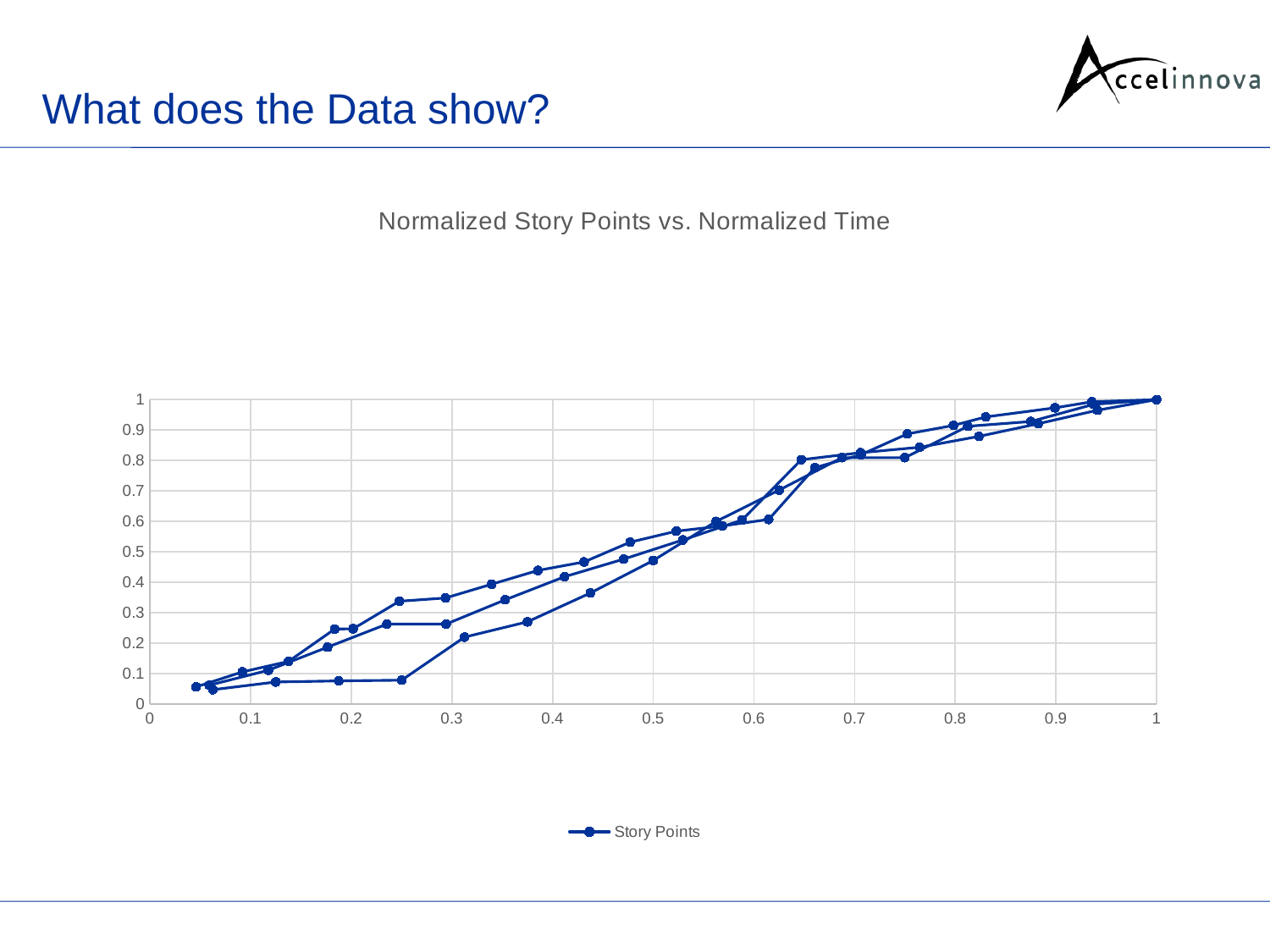
Are the plotted values at x = 0.2 greater or less than 0.4? less What is the name of the series shown in the legend? Story Points Are the plotted values at x = 0.7 greater or less than 0.6? greater How many separate lines are plotted on the chart? 3 What is the highest tick value shown on the y axis? 1 Are the plotted values at x = 0.9 greater or less than 0.8? greater Do the plotted values rise or fall as normalized time increases along the x axis? rise What kind of chart is shown on the slide? line chart What is the title of the chart? Normalized Story Points vs. Normalized Time What value do all the lines reach at the right end of the x axis (x = 1)? 1 How many series does the legend list? 1